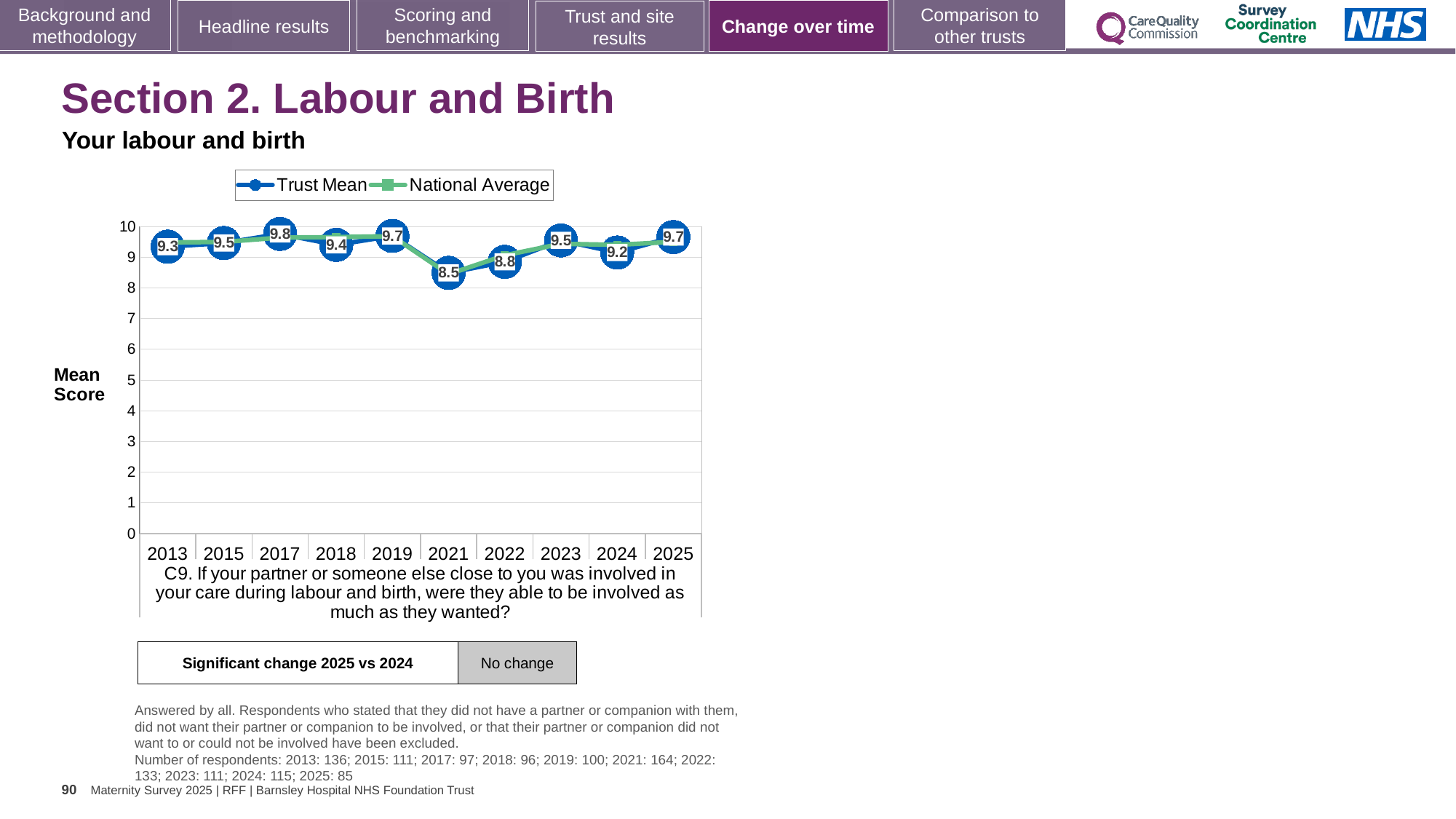
How many years are plotted on the x axis? 10 What is the Trust Mean for 2025? 9.7 What is the label of the y axis? Mean Score What kind of chart is shown? line chart Which year has the lowest Trust Mean? 2021 How many series does the legend list? 2 What is the Trust Mean for 2017? 9.8 What is the Trust Mean for 2021? 8.5 Which is larger, the Trust Mean for 2024 or for 2025? 2025 What is the difference between the Trust Mean in 2017 and in 2021? 1.3 Which year has the highest Trust Mean? 2017 Is the Trust Mean for 2022 greater or less than 9? less